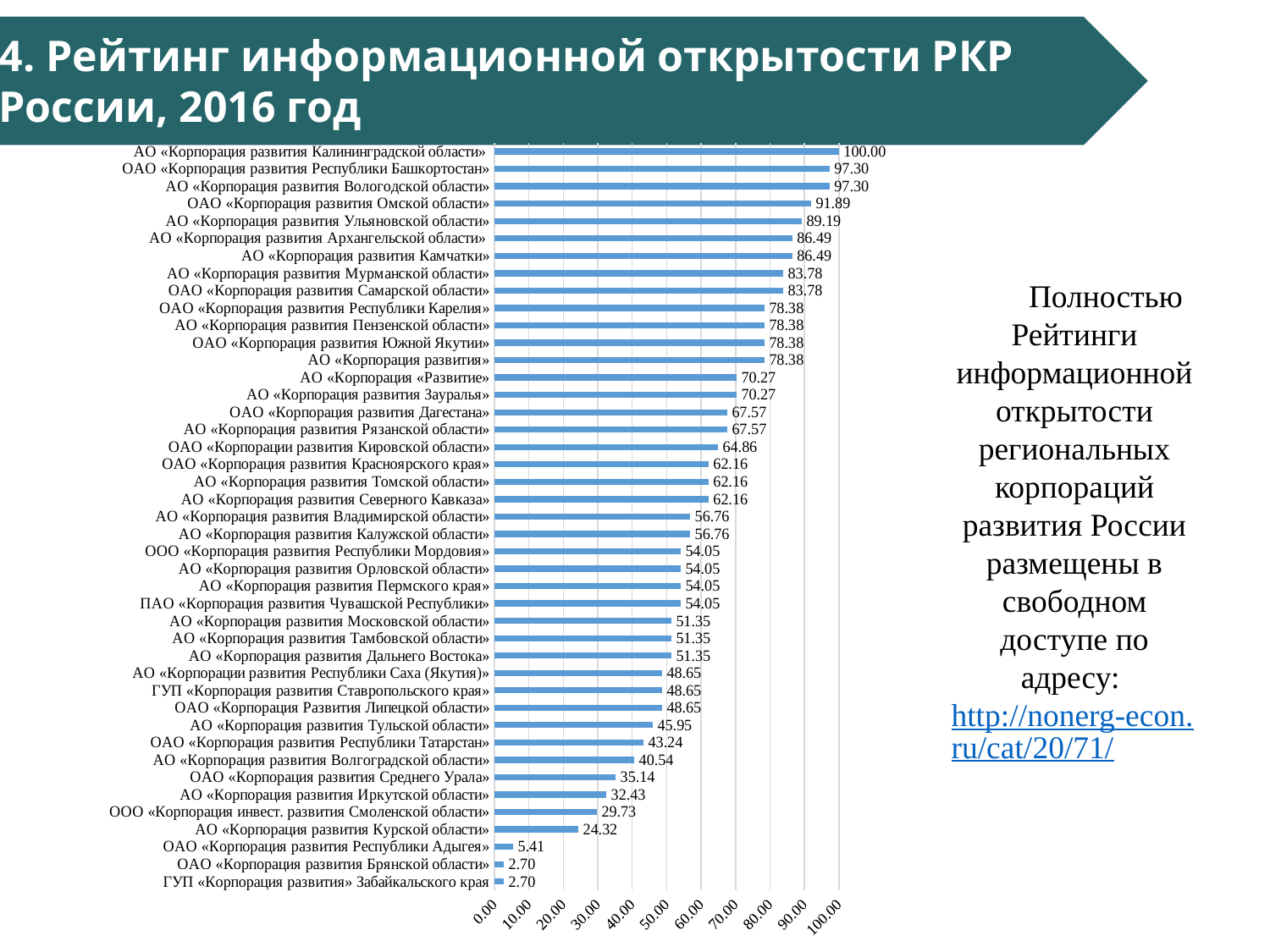
What is the title of the slide? 4. Рейтинг информационной открытости РКР России, 2016 год What is the value for ОАО «Корпорация развития Республики Адыгея»? 5.41 Which category has the highest value? АО «Корпорация развития Калининградской области» Which is larger, the value for ОАО «Корпорация развития Среднего Урала» or the value for АО «Корпорация развития Иркутской области»? ОАО «Корпорация развития Среднего Урала» How many categories are shown on the chart? 43 What is the value for АО «Корпорация развития Калининградской области»? 100.00 What is the value for АО «Корпорация развития Курской области»? 24.32 Is the value for АО «Корпорация развития Мурманской области» greater or less than 80.00? greater What is the value for ОАО «Корпорация развития Омской области»? 91.89 What is the lowest value shown on the chart? 2.70 What kind of chart is shown on the slide? bar chart What is the difference between the values for АО «Корпорация развития Ульяновской области» and АО «Корпорация развития Тульской области»? 43.24